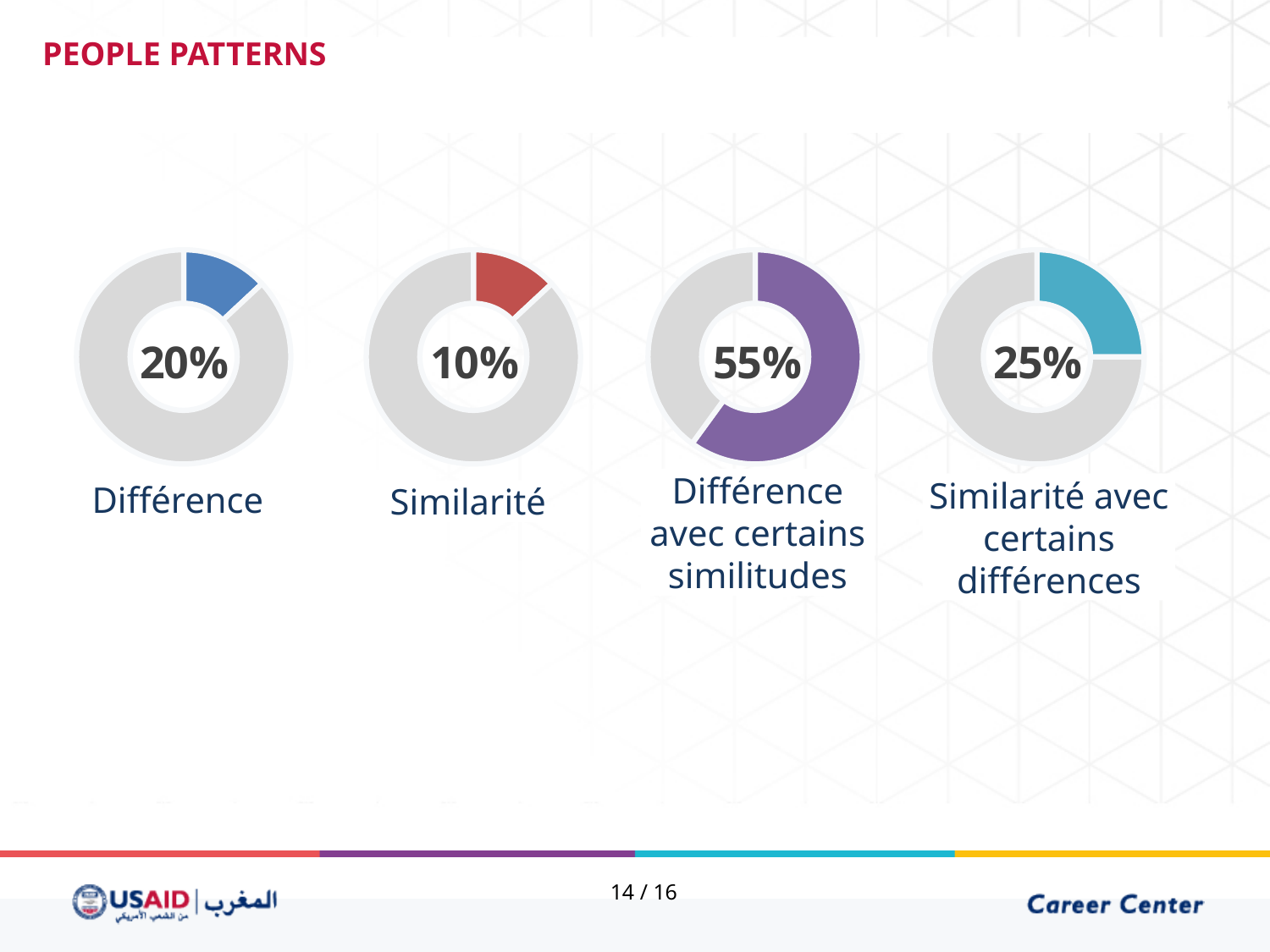
What kind of chart is used to display each percentage on the slide? Donut (pie) chart What is the difference between the percentage in the "Différence avec certains similitudes" chart and the percentage in the "Différence" chart? 35% What percentage is shown in the donut chart labelled "Différence avec certains similitudes"? 55% What is the difference between the percentage in the "Similarité avec certains différences" chart and the percentage in the "Similarité" chart? 15% What percentage is shown in the donut chart labelled "Similarité avec certains différences"? 25% What percentage is shown in the donut chart labelled "Différence"? 20% Which of the four donut charts shows the lowest percentage? Similarité Which is larger: the percentage in the "Différence" chart or the percentage in the "Similarité avec certains différences" chart? Similarité avec certains différences Which of the four donut charts shows the highest percentage? Différence avec certains similitudes What colour is the filled segment of the donut chart labelled "Différence avec certains similitudes"? Purple How many donut charts are shown on the slide? 4 What percentage is shown in the donut chart labelled "Similarité"? 10%